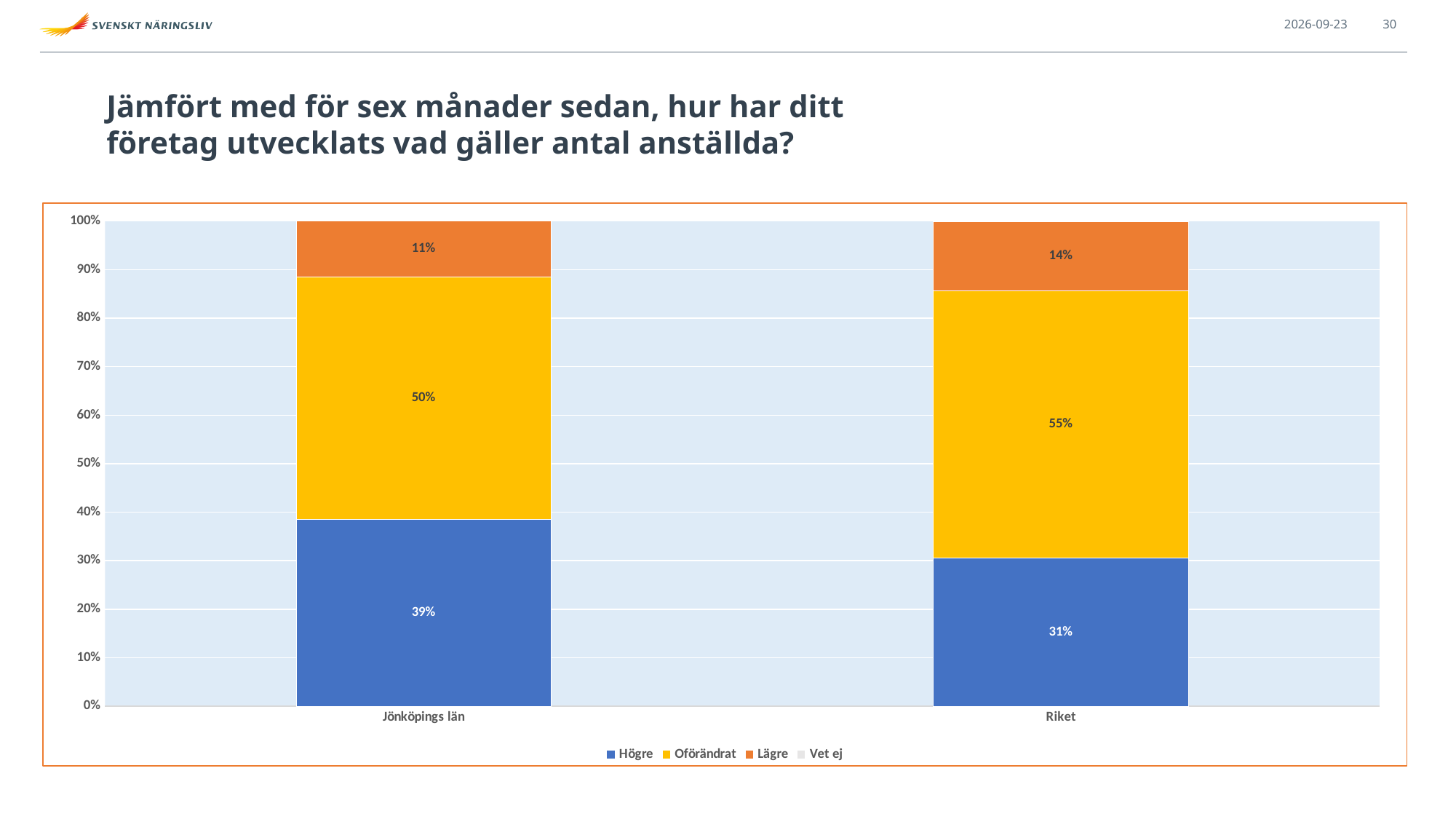
What kind of chart is shown on the slide? Stacked bar chart What is the value for Lägre in Jönköpings län? 11% Which series has the largest value in Jönköpings län? Oförändrat What is the value for Högre in Jönköpings län? 39% How many series does the legend list? 4 How many categories are shown on the x axis? 2 What is the value for Högre in Riket? 31% What is the difference between the Oförändrat values for Riket and Jönköpings län? 5% What is the value for Oförändrat in Riket? 55% Which category has the higher value for Lägre, Jönköpings län or Riket? Riket What is the difference between the Högre values for Jönköpings län and Riket? 8%